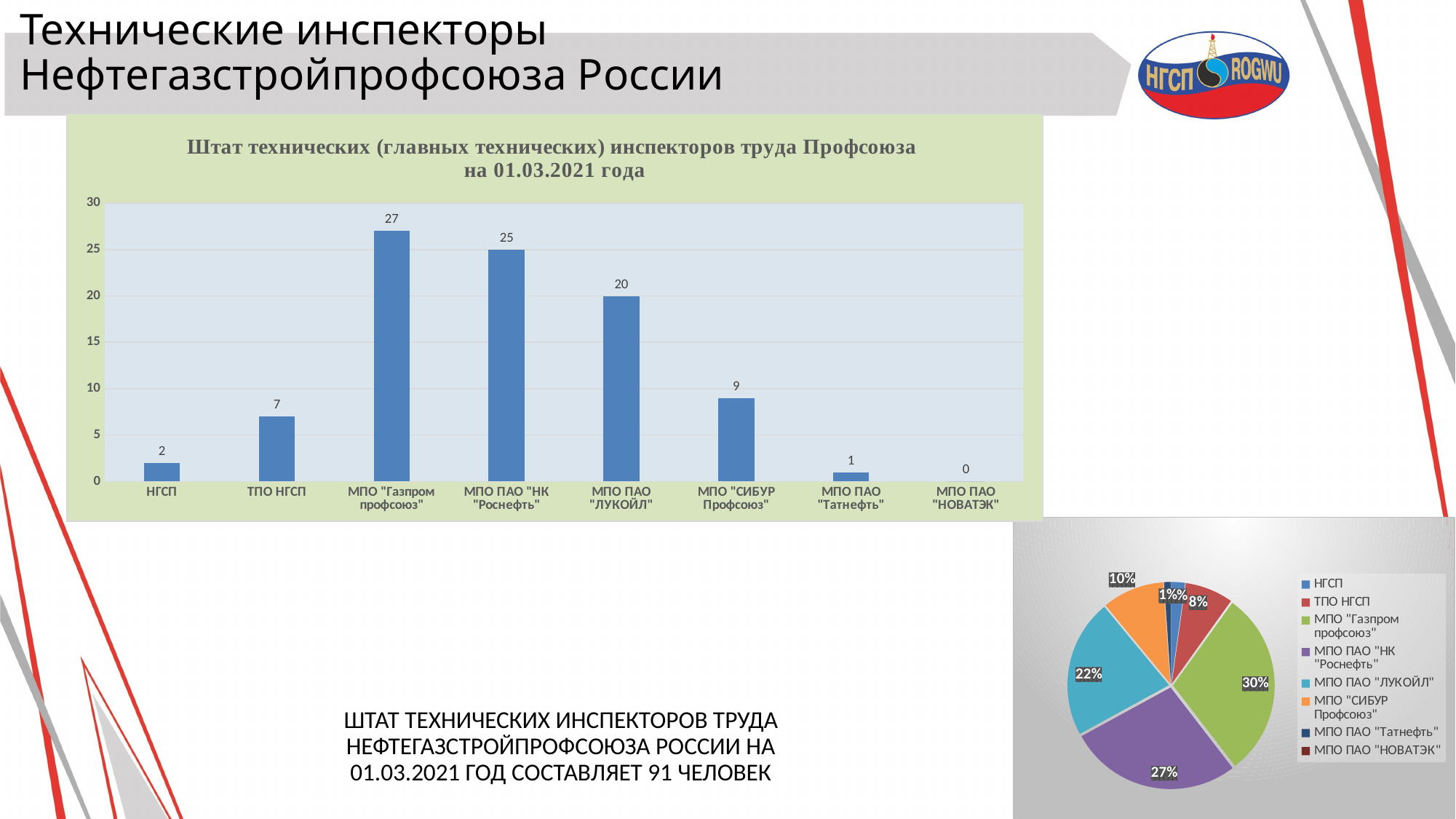
In the pie chart at the bottom right, what share does the МПО ПАО "ЛУКОЙЛ" slice have? 22% In the bar chart, which category has the highest value? МПО "Газпром профсоюз" In the pie chart at the bottom right, what share does the МПО "Газпром профсоюз" slice have? 30% In the bar chart, which is larger: the value for НГСП or the value for МПО ПАО "Татнефть"? НГСП In the bar chart, what is the value for МПО ПАО "ЛУКОЙЛ"? 20 How many categories are shown on the x axis of the bar chart? 8 In the bar chart, what is the difference between the values for МПО ПАО "НК "Роснефть"" and МПО "СИБУР Профсоюз"? 16 In the bar chart, which category has the lowest value? МПО ПАО "НОВАТЭК" What kind of chart is the chart at the top of the slide? bar chart In the bar chart, how many technical inspectors does МПО "Газпром профсоюз" have? 27 In the bar chart, what is the value for ТПО НГСП? 7 How many entries does the legend of the pie chart at the bottom right list? 8